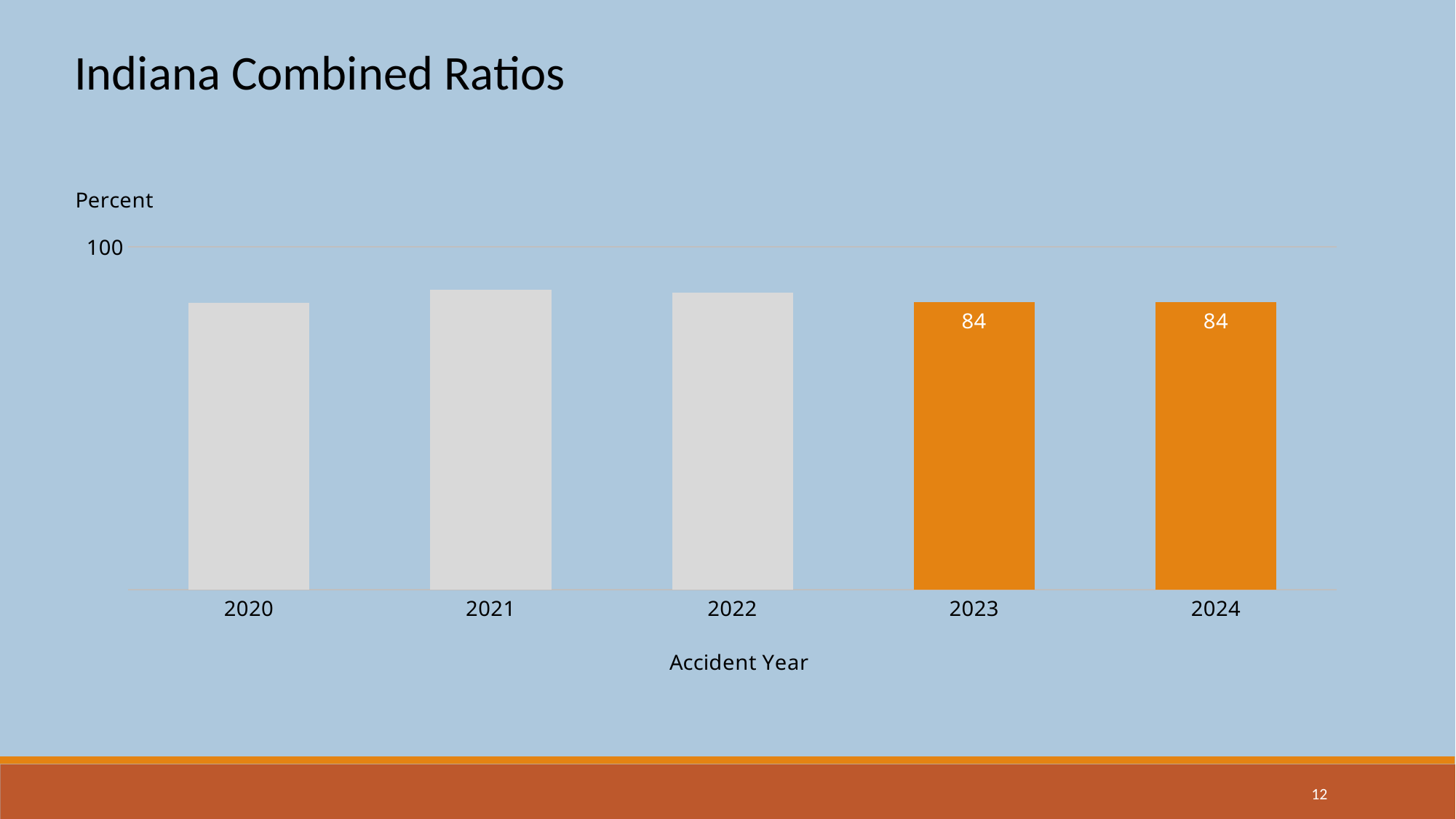
Which is larger, the value for 2021 or the value for 2023? 2021 What is the title of the chart? Indiana Combined Ratios Is the value for 2022 greater or less than 100? less What is the value for 2024? 84 Is the value for 2020 greater or less than 100? less Which is larger, the value for 2022 or the value for 2024? 2022 How many accident years are shown on the x axis? 5 What is the difference between the values for 2023 and 2024? 0 What is the label of the x axis? Accident Year Is the value for 2021 greater or less than 100? less What kind of chart is shown on the slide? bar chart What is the value for 2023? 84